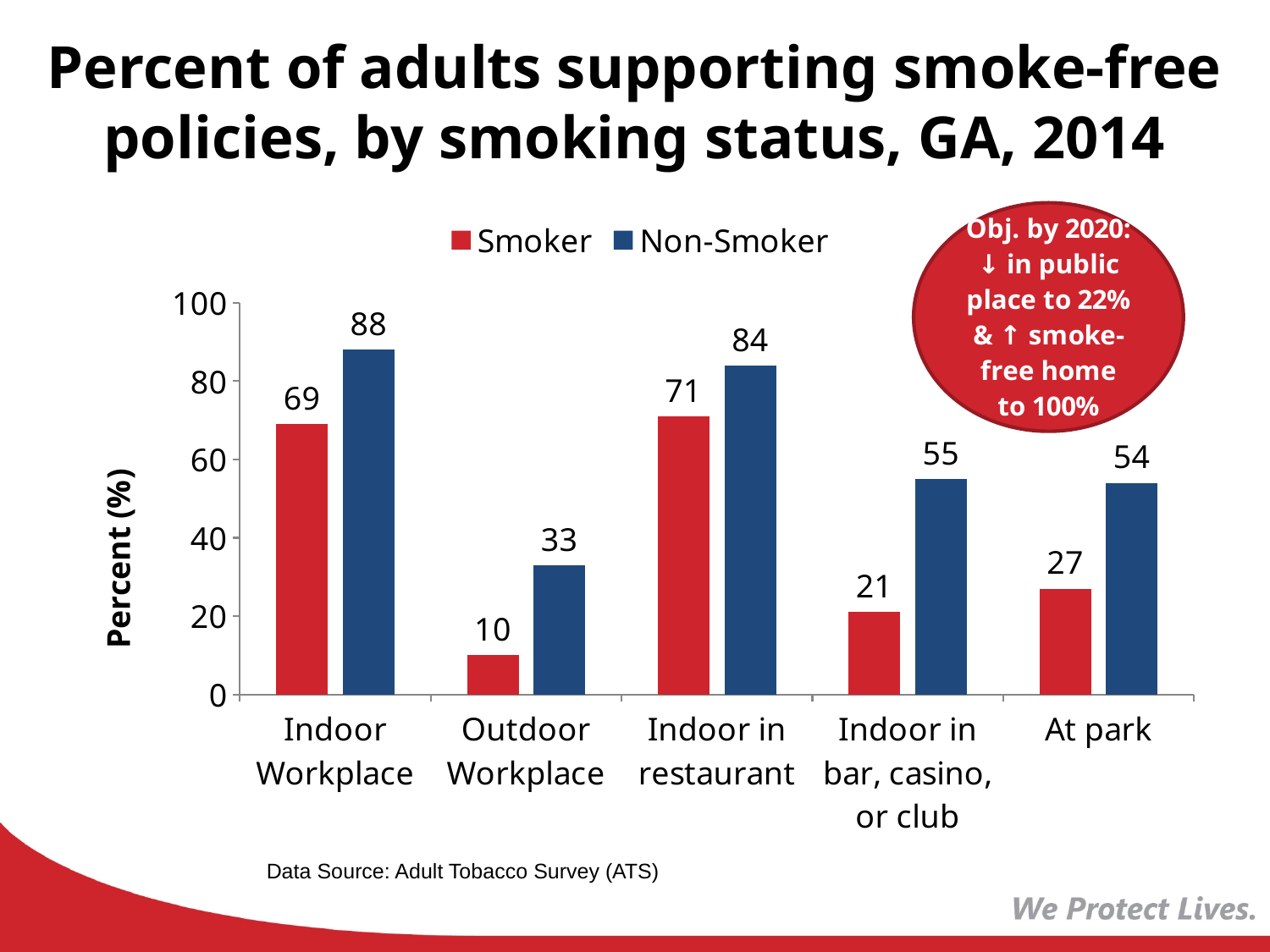
How many series does the legend list? 2 Is the Smoker value for Indoor in restaurant greater or less than 60? greater Which category has the highest Non-Smoker value? Indoor Workplace What is the label of the y axis? Percent (%) What is the Smoker value for Indoor in bar, casino, or club? 21 Which is larger for At park: the Smoker value or the Non-Smoker value? Non-Smoker What percent of smokers support smoke-free policies for Indoor Workplace? 69 What kind of chart is shown on the slide? bar chart Which category has the lowest Smoker value? Outdoor Workplace What is the difference between the Non-Smoker and Smoker values for Indoor in restaurant? 13 What percent of non-smokers support smoke-free policies for Outdoor Workplace? 33 How many categories are shown on the x axis? 5